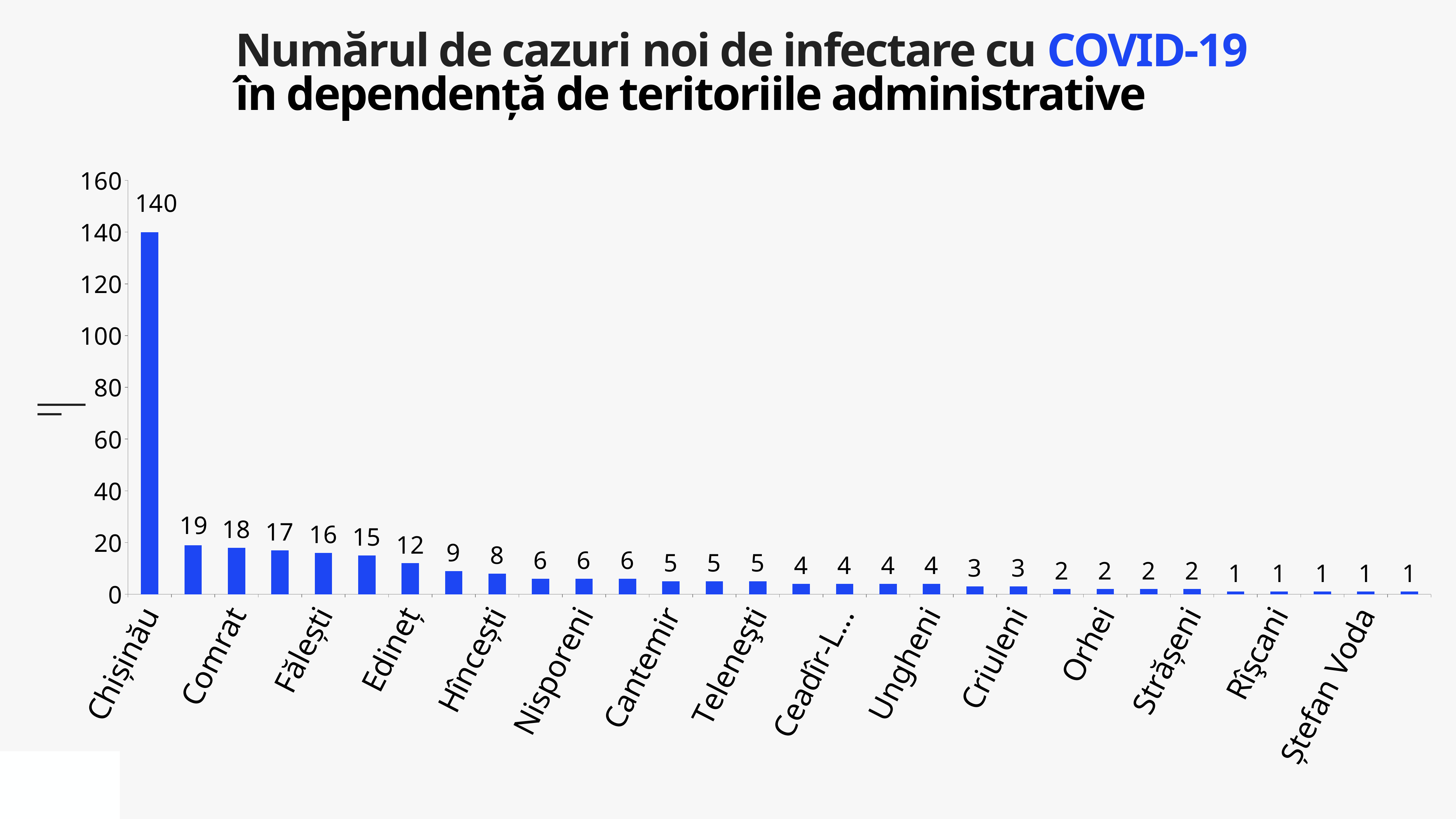
How many new COVID-19 cases are shown for Chișinău? 140 Which has a larger value, Fălești or Edineț? Fălești What is the value shown for Comrat? 18 Do the values rise or fall from left to right along the x axis? fall Is the value for Chișinău greater or less than 120? greater What is the difference between the values for Chișinău and Comrat? 122 How many bars are plotted in the chart? 30 What is the value shown for Hîncești? 8 What is the value shown for Edineț? 12 What type of chart is shown on the slide? bar chart What is the value shown for Fălești? 16 Which administrative territory has the highest number of new cases? Chișinău